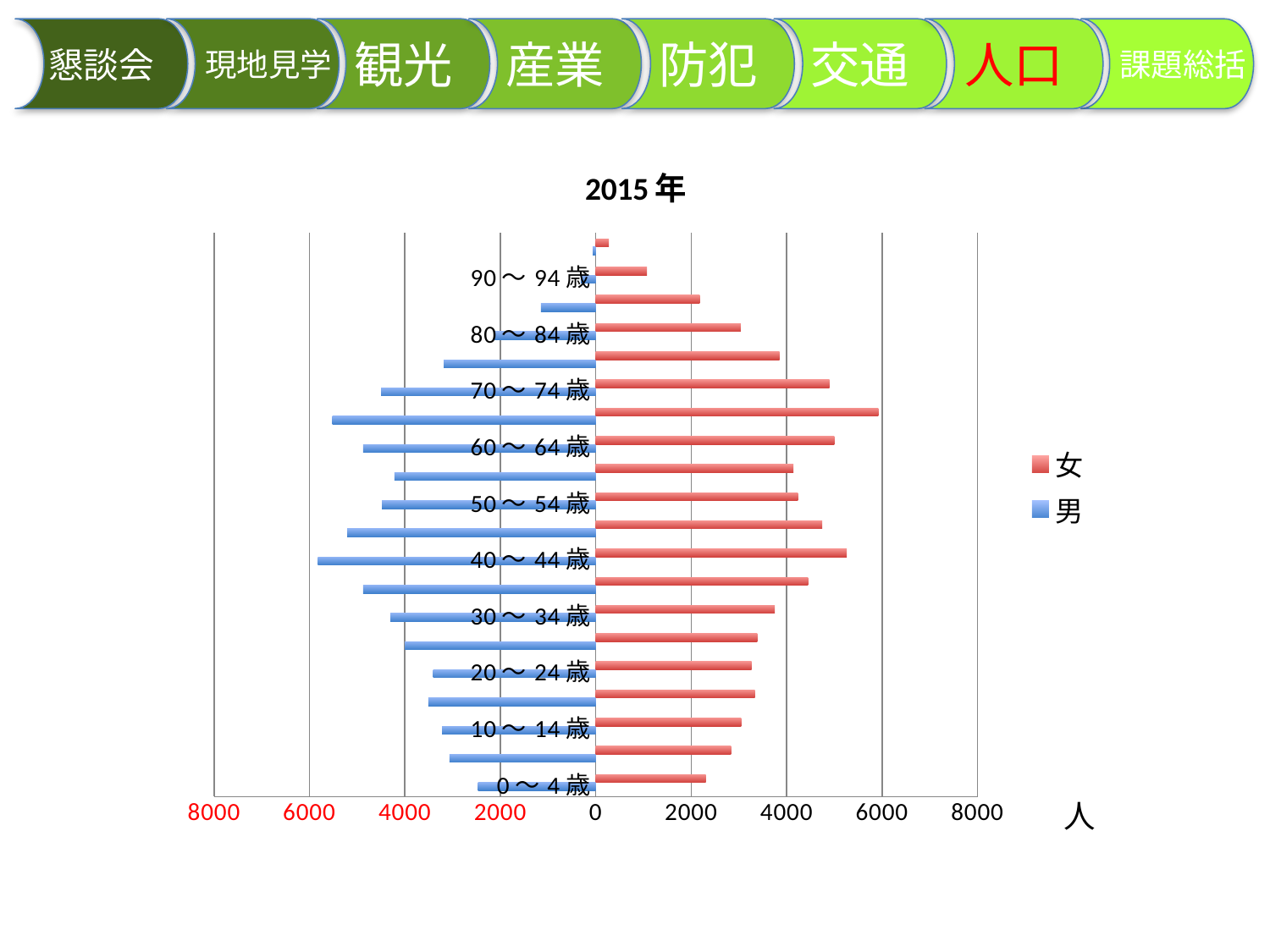
Is the 女 value for 40～44歳 greater or less than 4000? greater What is the title of the chart? 2015年 Is the 女 value for 90～94歳 greater or less than 2000? less How many age-group labels are printed on the vertical axis? 10 Is the 男 value for 0～4歳 greater or less than 4000? less How many series does the legend list? 2 What kind of chart is shown on the slide? bar chart For 90～94歳, which is larger, the 女 value or the 男 value? 女 Which series is drawn in blue according to the legend? 男